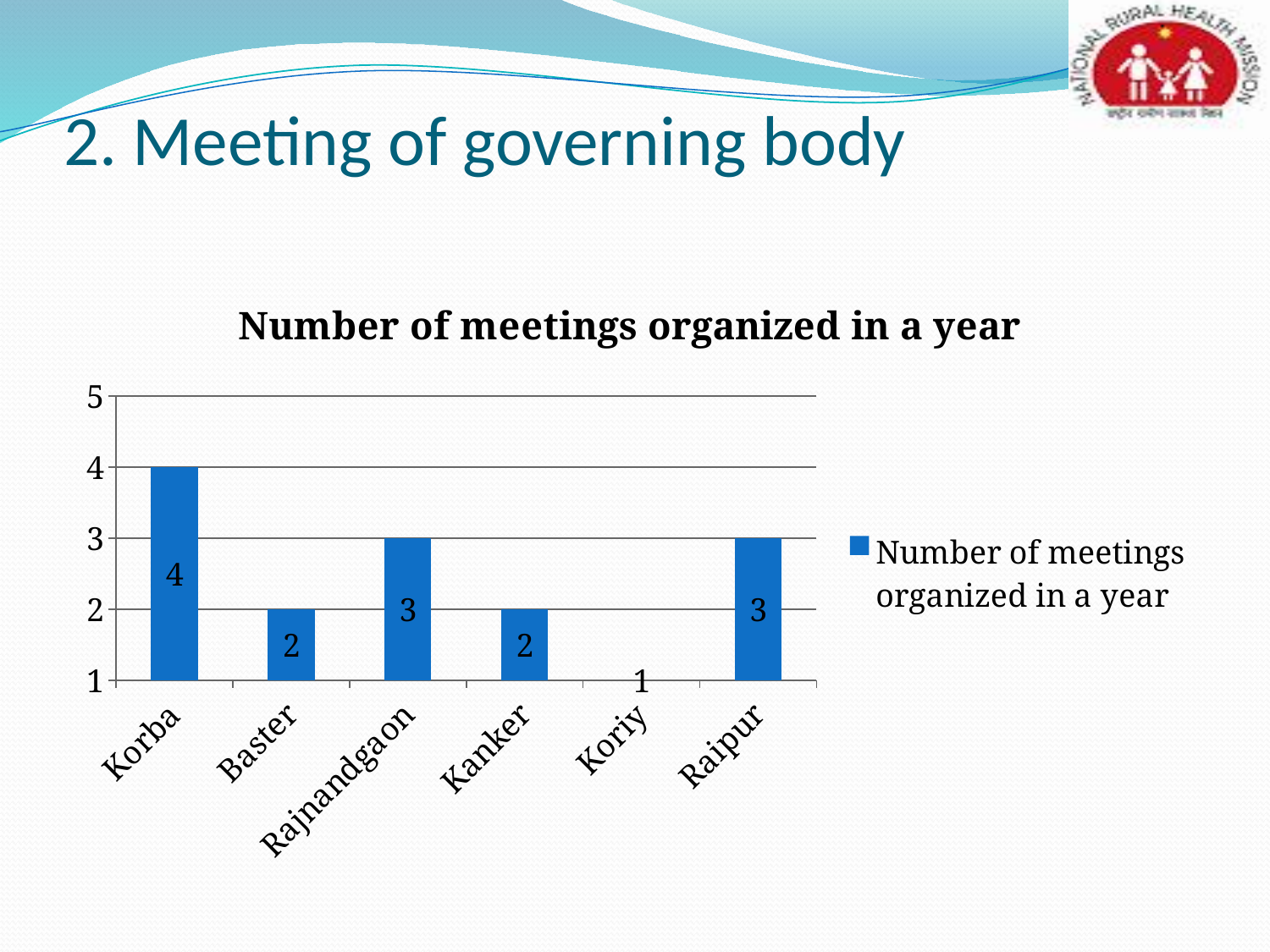
What is the difference between the number of meetings for Korba and Kanker? 2 Which district has the lowest number of meetings organized in a year? Koriy Which district has the highest number of meetings organized in a year? Korba What is the number of meetings organized in a year for Koriy? 1 What is the number of meetings organized in a year for Korba? 4 How many districts are shown on the x axis of the chart? 6 What is the number of meetings organized in a year for Baster? 2 What is the number of meetings organized in a year for Rajnandgaon? 3 How many series does the legend list? 1 What is the title of the chart? Number of meetings organized in a year Which has more meetings organized in a year, Raipur or Baster? Raipur What kind of chart is shown on the slide? Bar chart